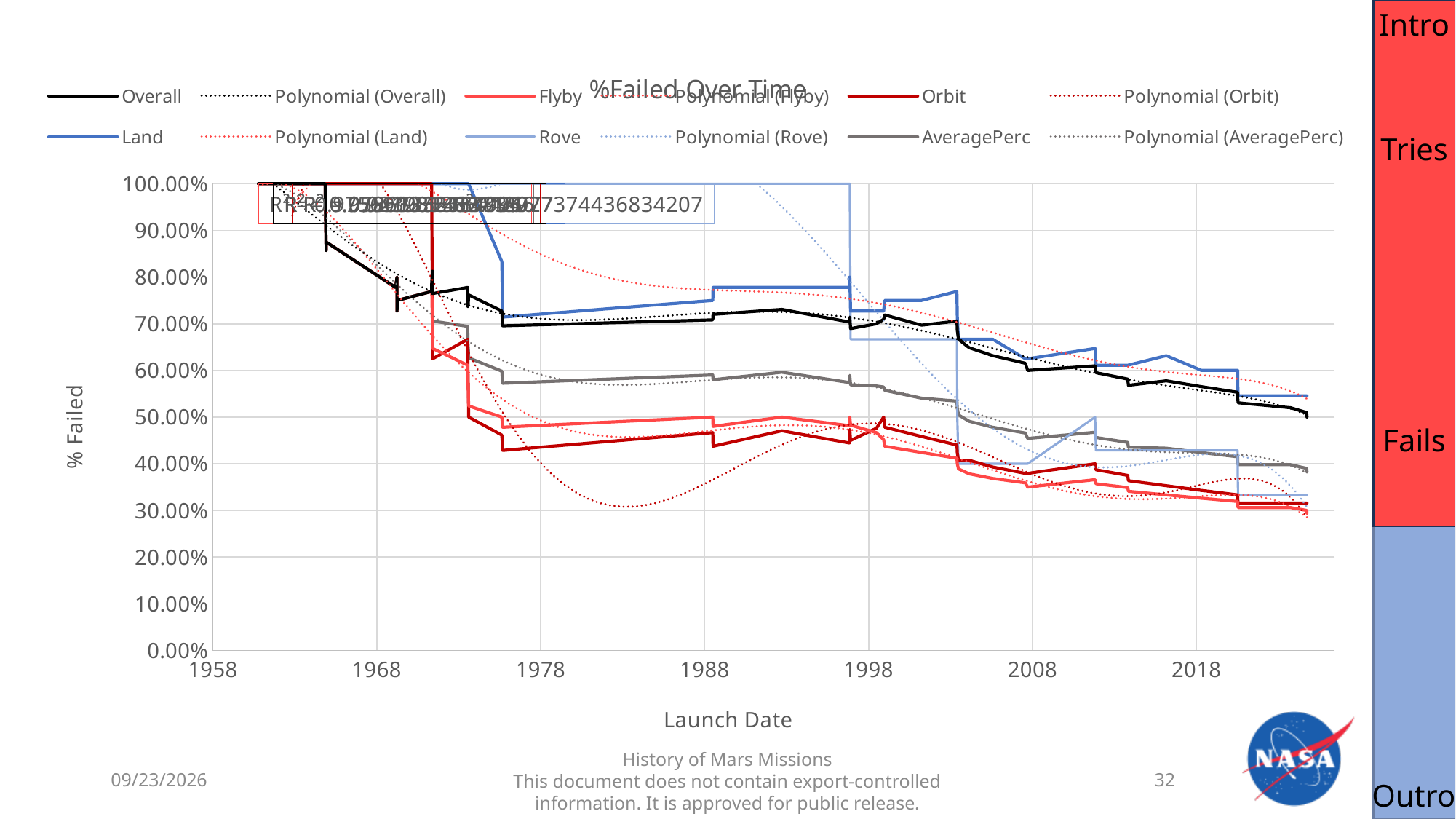
What is the label on the x axis of the chart? Launch Date How many series does the legend list? 12 At 2018, which is larger, the value for Land or the value for Flyby? Land Is the value for Flyby at 2018 greater or less than 40.00%? less Does the Flyby series rise or fall from 1968 to 2018? fall Does the Overall series rise or fall from 1968 to 2018? fall Is the value for Land at 1988 greater or less than 70.00%? greater Is the value for Overall at 2018 greater or less than 50.00%? greater What kind of chart is shown on the slide? line chart What is the title of the chart? %Failed Over Time At 1988, which is larger, the value for Land or the value for Orbit? Land